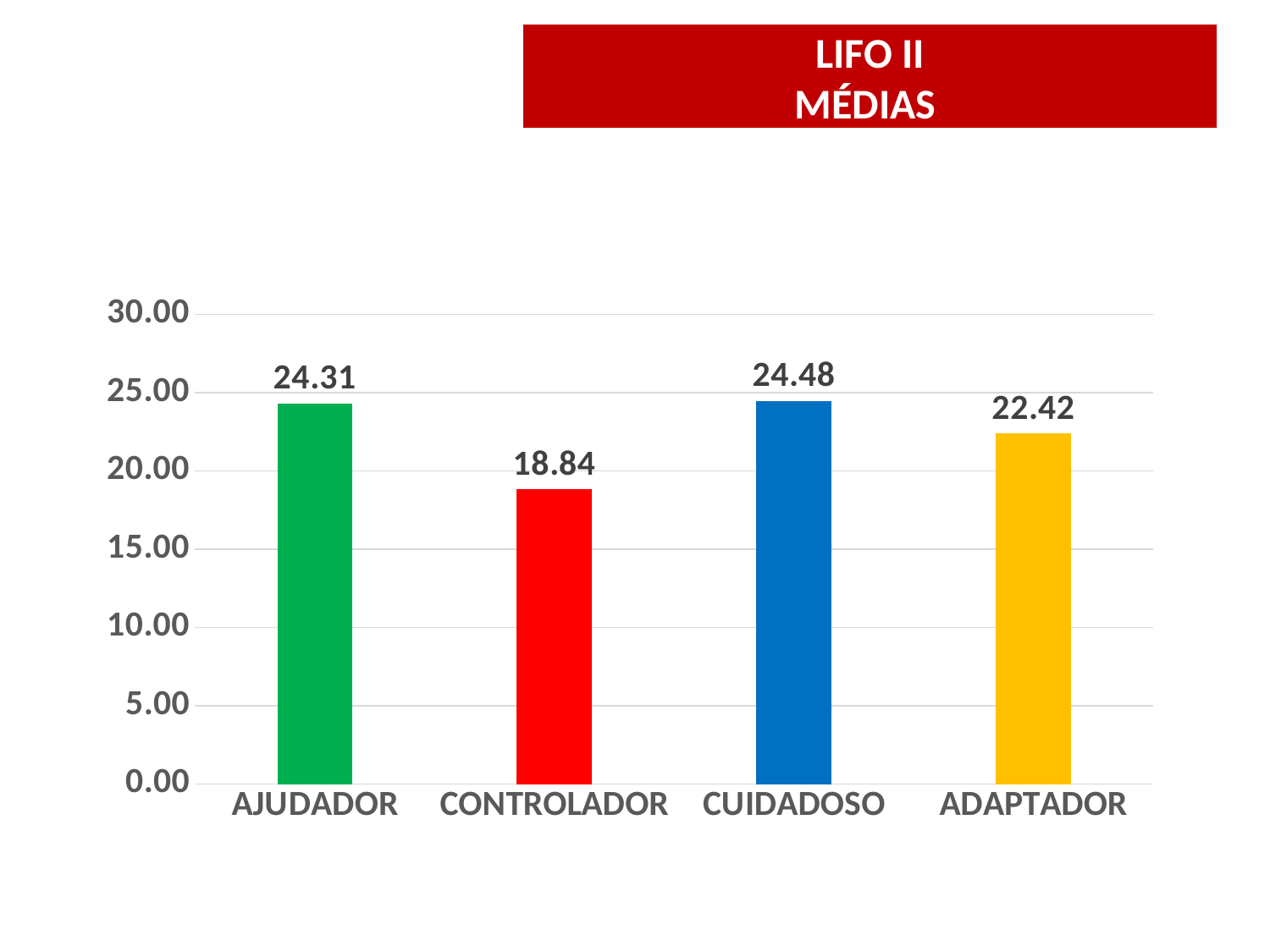
What is the value for CONTROLADOR? 18.84 How many categories are shown on the chart? 4 Which is larger, the value for ADAPTADOR or the value for CONTROLADOR? ADAPTADOR What is the value for CUIDADOSO? 24.48 What is the difference between the values for AJUDADOR and CONTROLADOR? 5.47 Which category has the lowest value? CONTROLADOR What kind of chart is shown on the slide? bar chart What is the difference between the values for CUIDADOSO and ADAPTADOR? 2.06 Is the value for CONTROLADOR greater or less than 20.00? less What is the value for ADAPTADOR? 22.42 Which category has the highest value? CUIDADOSO What is the value for AJUDADOR? 24.31